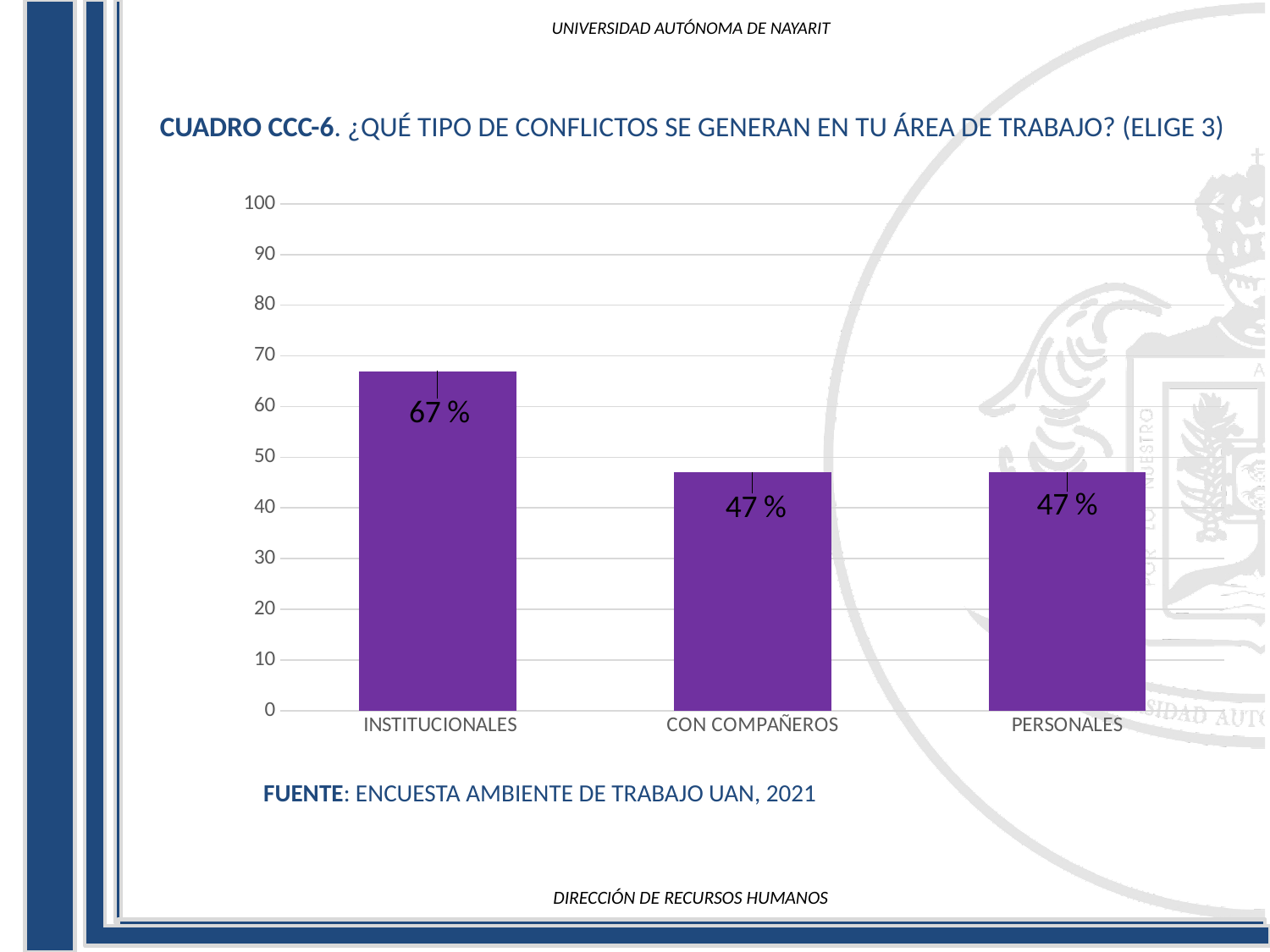
How many categories are shown on the x axis? 3 What is the source cited below the chart? ENCUESTA AMBIENTE DE TRABAJO UAN, 2021 What kind of chart is shown on the slide? bar chart Is the value for INSTITUCIONALES greater or less than 60? greater What is the value for CON COMPAÑEROS? 47 % What is the difference between the values for INSTITUCIONALES and CON COMPAÑEROS? 20 % What is the value for INSTITUCIONALES? 67 % Which is larger, the value for INSTITUCIONALES or the value for PERSONALES? INSTITUCIONALES What is the value for PERSONALES? 47 % Is the value for PERSONALES greater or less than 50? less Which category has the highest value? INSTITUCIONALES What is the maximum value shown on the y axis? 100